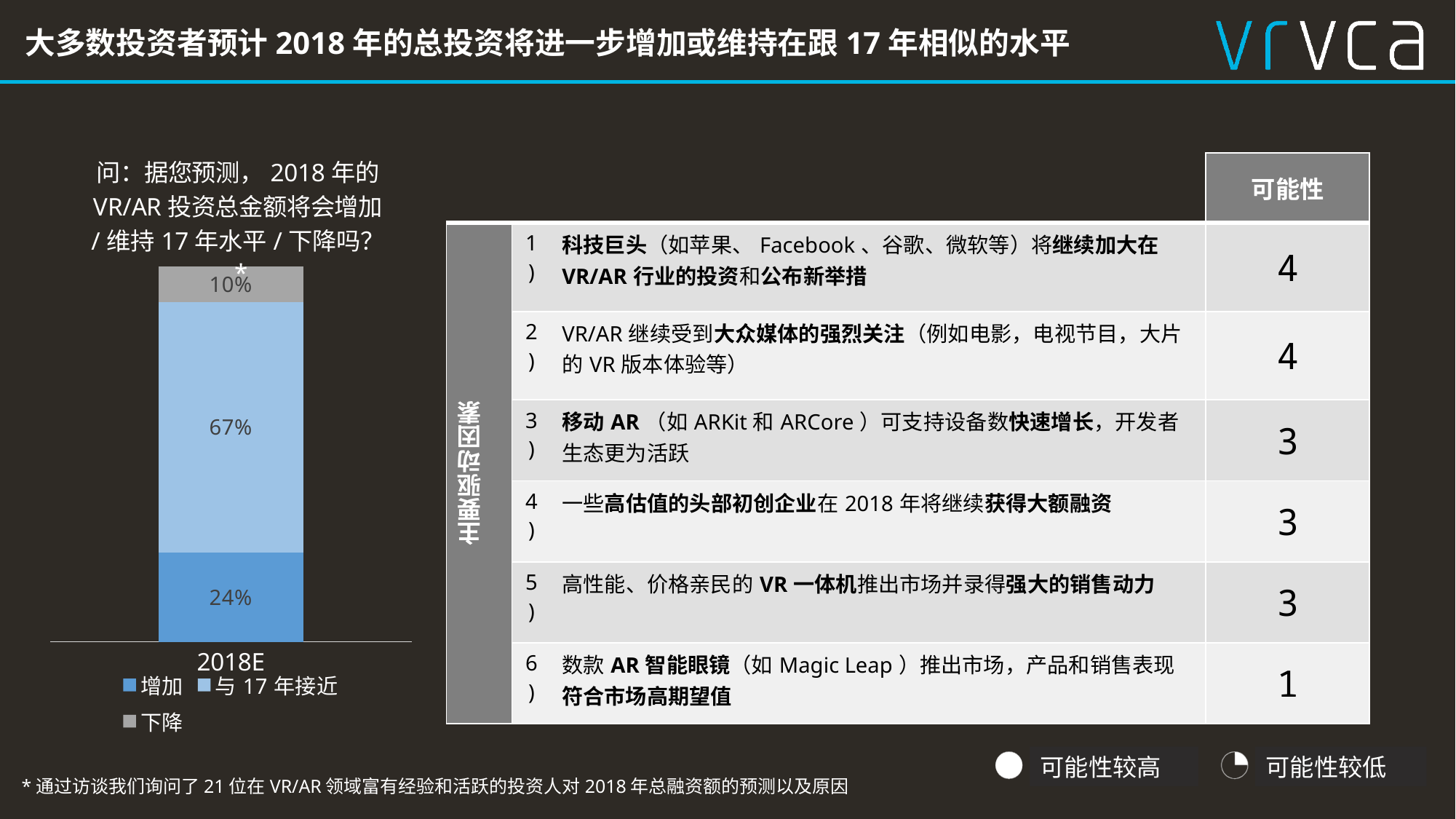
Which is larger: the share expecting an increase (增加) or the share expecting a decrease (下降)? 增加 What is the difference between the share expecting a level close to 2017 (与 17 年接近) and the share expecting an increase (增加)? 43% What is the difference between the share expecting an increase (增加) and the share expecting a decrease (下降)? 14% What is the category label on the x axis of the chart? 2018E Which response has the largest share in the 2018E bar? 与 17 年接近 What percentage of investors expect VR/AR investment in 2018E to increase (增加)? 24% What type of chart is shown on the slide? Stacked bar chart How many categories are shown on the x axis of the chart? 1 Which response has the smallest share in the 2018E bar? 下降 What percentage of investors expect VR/AR investment to decrease (下降) in 2018E? 10% What percentage of investors expect 2018E investment to be close to the 2017 level (与 17 年接近)? 67% How many series does the chart legend list? 3